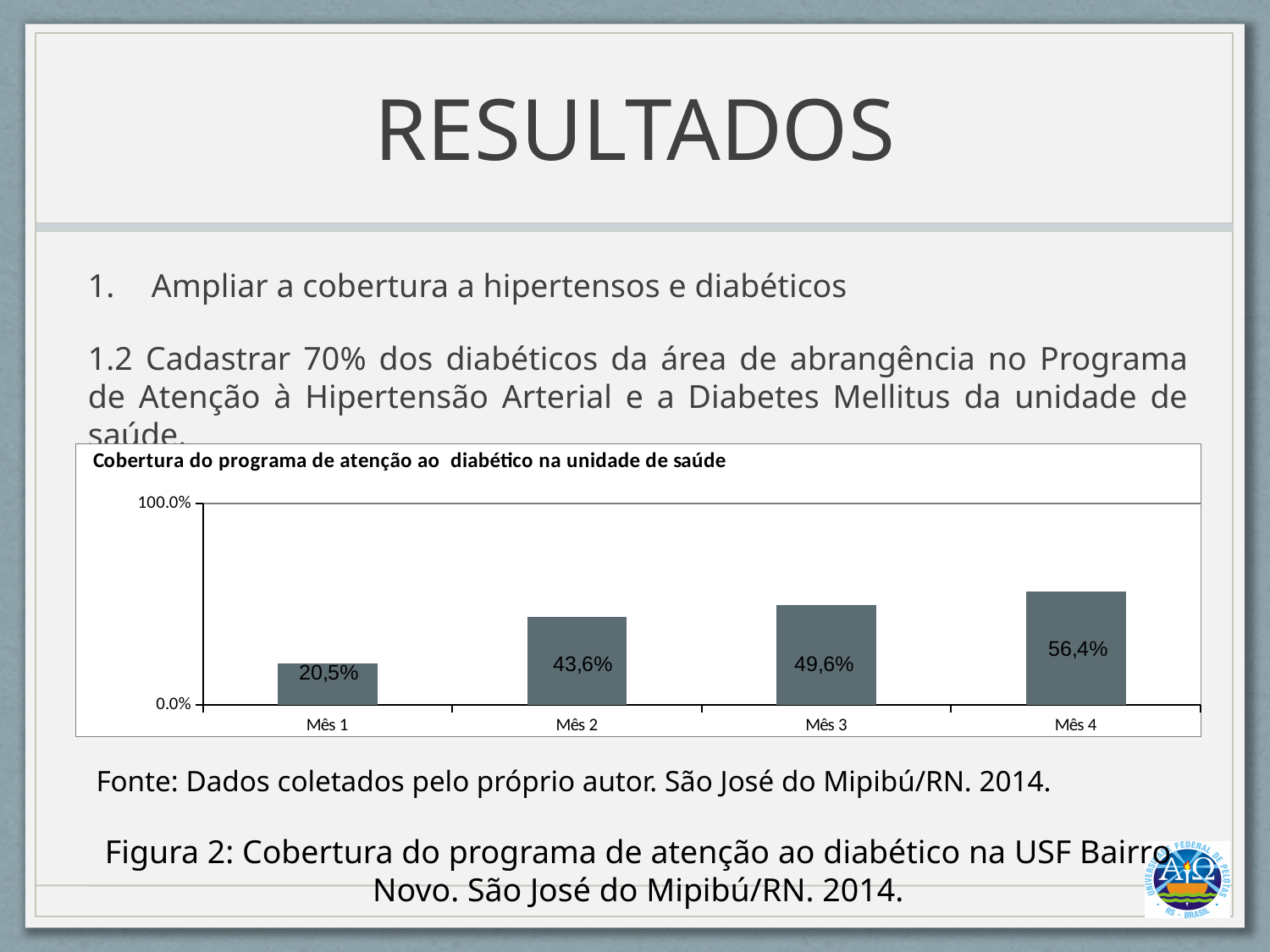
What is the difference between the values for Mês 3 and Mês 2? 6,0% What kind of chart is shown on the slide? Bar chart What is the difference between the values for Mês 4 and Mês 1? 35,9% What is the value for Mês 4? 56,4% What is the value for Mês 1? 20,5% Which month has the lowest coverage value? Mês 1 What is the title of the chart? Cobertura do programa de atenção ao diabético na unidade de saúde Do the values rise or fall from Mês 1 to Mês 4? Rise What is the value for Mês 3? 49,6% Which is larger, the value for Mês 2 or the value for Mês 3? Mês 3 How many months (categories) are shown on the x axis? 4 Which month has the highest coverage value? Mês 4